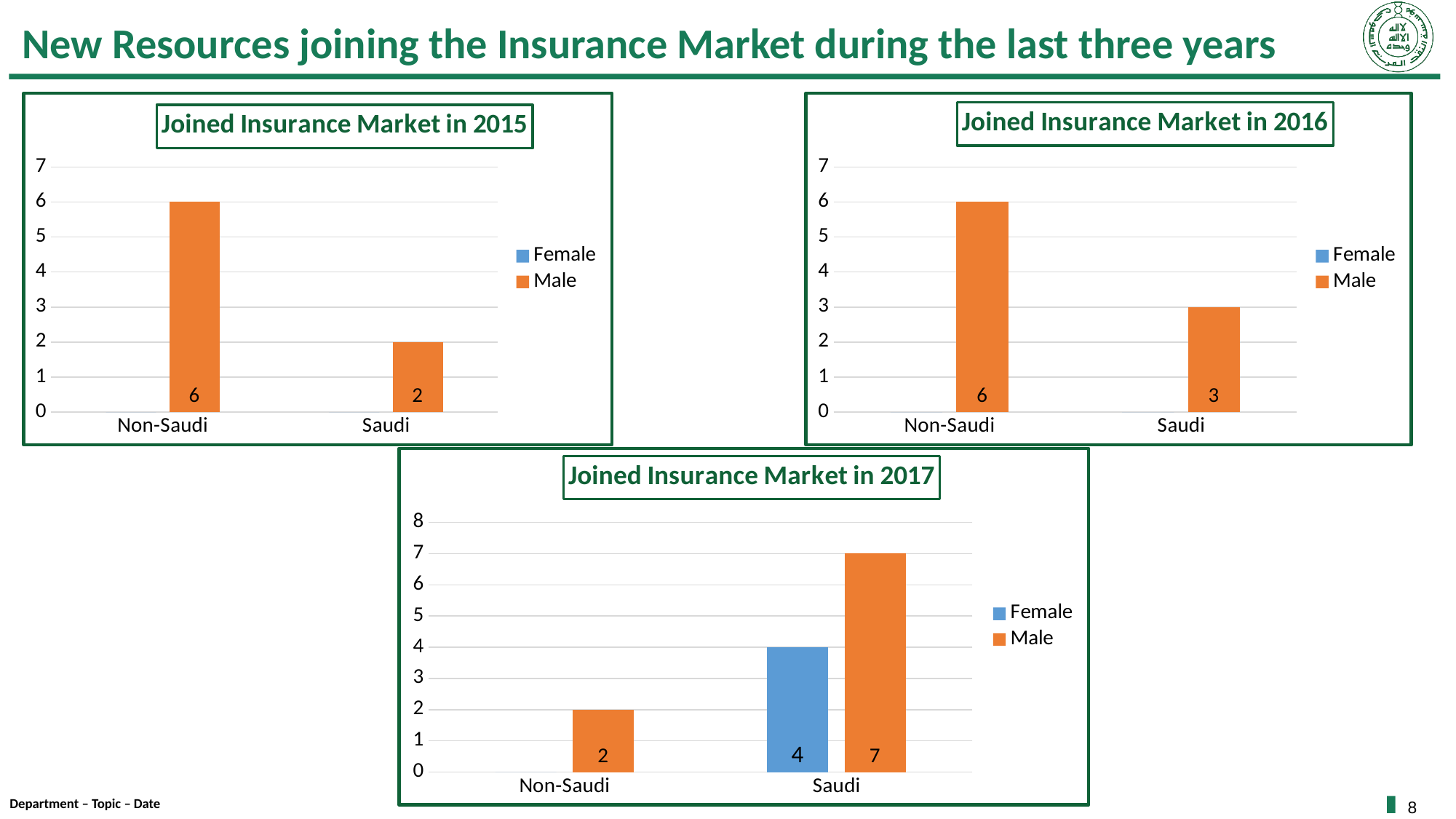
In the 'Joined Insurance Market in 2015' chart, what is the Male value for Saudi? 2 In the 'Joined Insurance Market in 2015' chart, how many categories are shown on the x axis? 2 In the 'Joined Insurance Market in 2017' chart, which category has the highest Male value? Saudi In the 'Joined Insurance Market in 2016' chart, what is the difference between the Male values for Non-Saudi and Saudi? 3 In the 'Joined Insurance Market in 2016' chart, what is the Male value for Saudi? 3 In the 'Joined Insurance Market in 2017' chart, what colour represents the Female series? Blue What type of chart is the 'Joined Insurance Market in 2016' chart? Bar chart In the 'Joined Insurance Market in 2017' chart, what is the Female value for Saudi? 4 In the 'Joined Insurance Market in 2017' chart, which is larger for Saudi: the Male value or the Female value? Male How many series does the legend of the 'Joined Insurance Market in 2017' chart list? 2 In the 'Joined Insurance Market in 2017' chart, what is the Male value for Non-Saudi? 2 In the 'Joined Insurance Market in 2015' chart, what is the Male value for Non-Saudi? 6